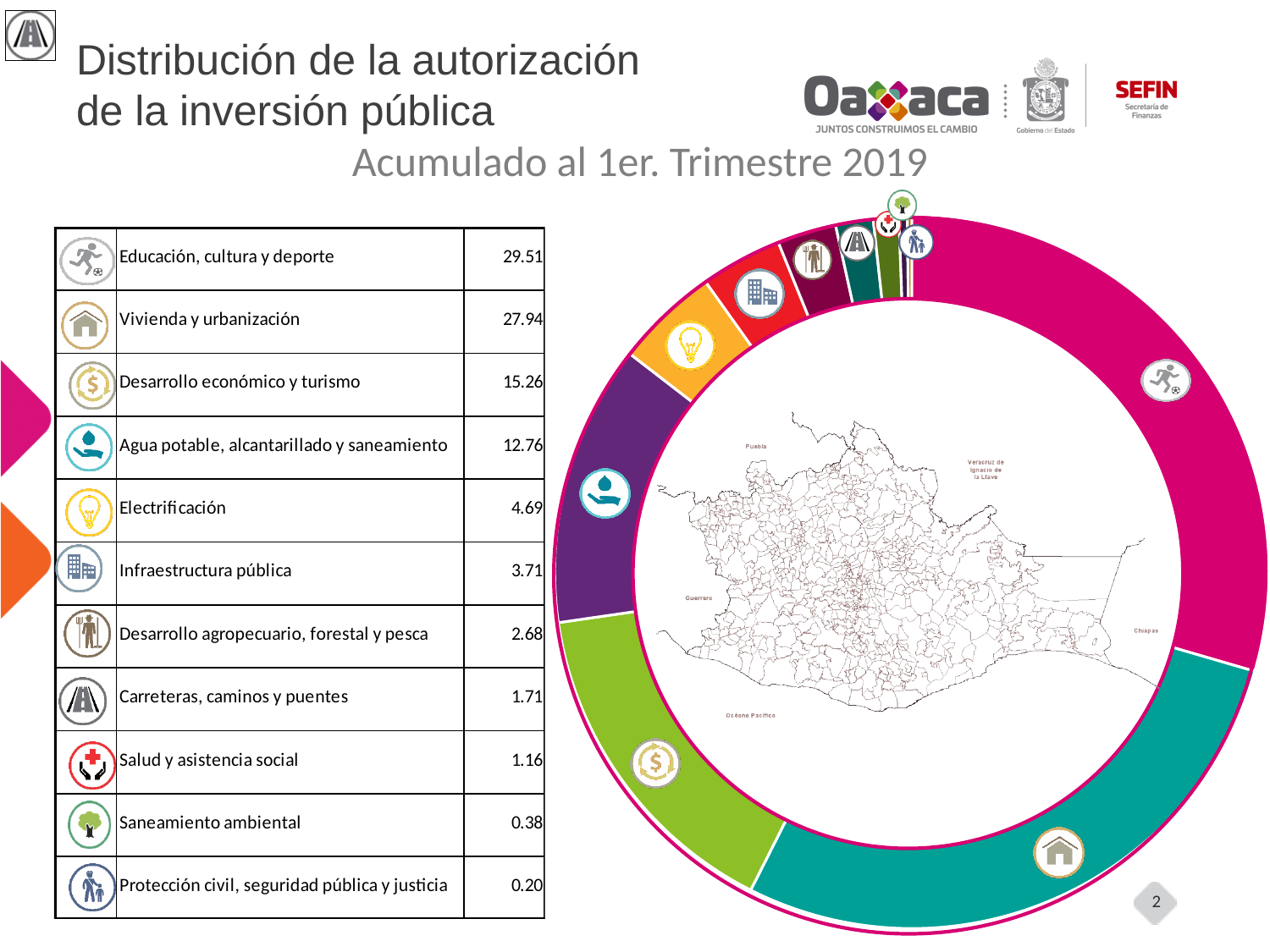
What kind of chart is shown on the slide? Doughnut (pie) chart What is the difference between the values for Educación, cultura y deporte and Vivienda y urbanización? 1.57 What value is shown for Agua potable, alcantarillado y saneamiento? 12.76 What is the subtitle shown above the chart? Acumulado al 1er. Trimestre 2019 What value is shown for Electrificación? 4.69 What value is shown for Salud y asistencia social? 1.16 How many categories are listed in the table accompanying the chart? 11 Which category has the lowest value? Protección civil, seguridad pública y justicia Which is larger, the value for Vivienda y urbanización or the value for Desarrollo económico y turismo? Vivienda y urbanización What value is shown for Educación, cultura y deporte? 29.51 Which category has the highest value? Educación, cultura y deporte What is the difference between the values for Desarrollo económico y turismo and Agua potable, alcantarillado y saneamiento? 2.50